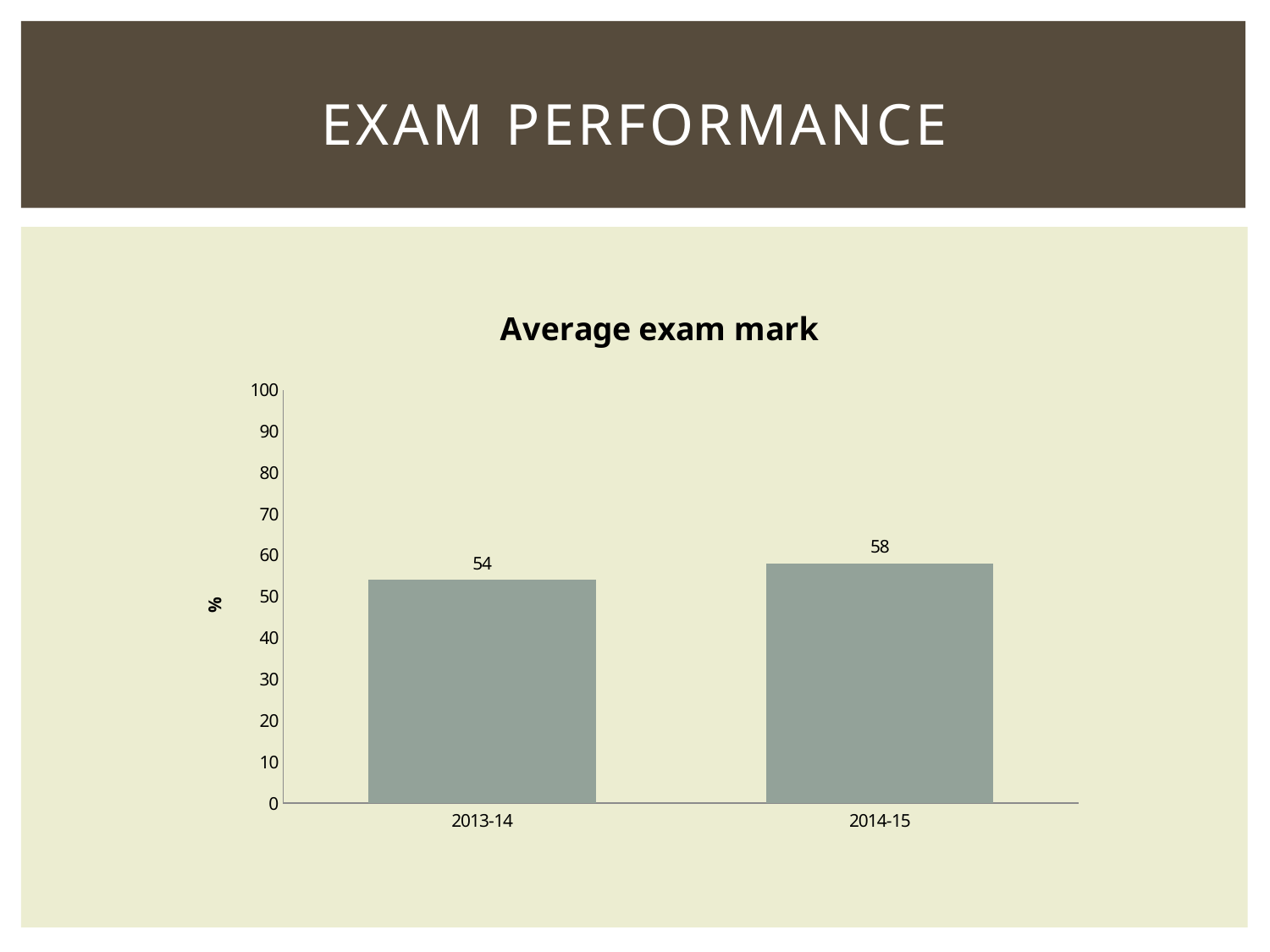
Which year has the lower average exam mark? 2013-14 What is the average exam mark for 2013-14? 54 What is the label on the vertical axis of the chart? % What is the average exam mark for 2014-15? 58 What kind of chart is shown on the slide? bar chart Which year has the higher average exam mark? 2014-15 What is the title of the chart? Average exam mark Does the average exam mark rise or fall from 2013-14 to 2014-15? rise How many years are shown on the chart? 2 Is the average exam mark for 2013-14 greater or less than 50? greater Is the average exam mark for 2014-15 greater or less than 60? less What is the difference between the average exam marks for 2014-15 and 2013-14? 4